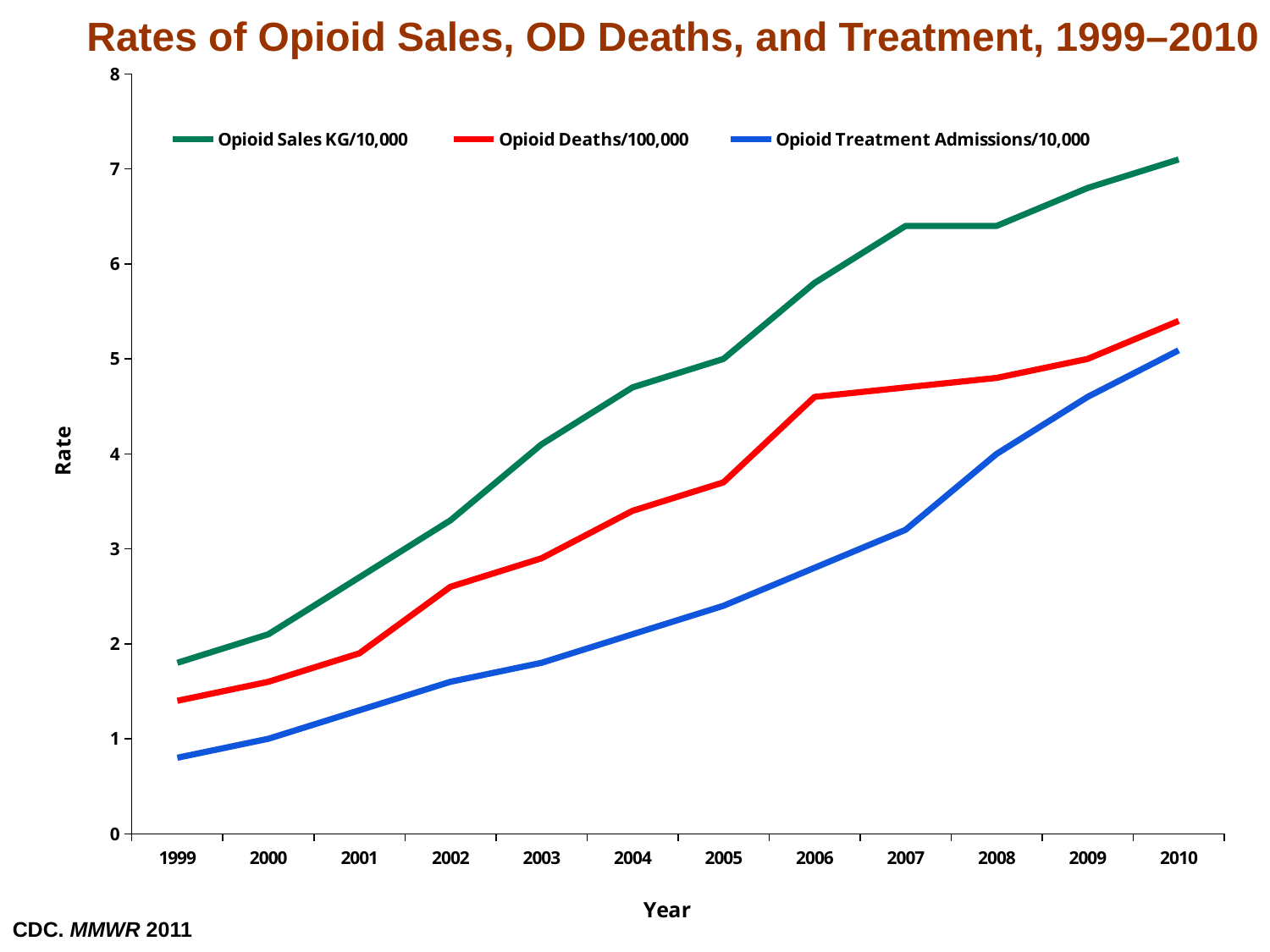
Is the value for Opioid Deaths/100,000 in 2006 greater or less than 4? greater Which is larger in 2007: Opioid Deaths/100,000 or Opioid Treatment Admissions/10,000? Opioid Deaths/100,000 Is the value for Opioid Sales KG/10,000 in 1999 greater or less than 2? less Which series has the lowest value in 1999? Opioid Treatment Admissions/10,000 Which series has the highest value in 2010? Opioid Sales KG/10,000 What is the title of the chart? Rates of Opioid Sales, OD Deaths, and Treatment, 1999–2010 How many years are plotted along the x axis? 12 Is the value for Opioid Treatment Admissions/10,000 in 2005 greater or less than 3? less What kind of chart is shown on the slide? line chart How many series does the legend list? 3 Does the Opioid Treatment Admissions/10,000 series rise or fall from 1999 to 2010? rise